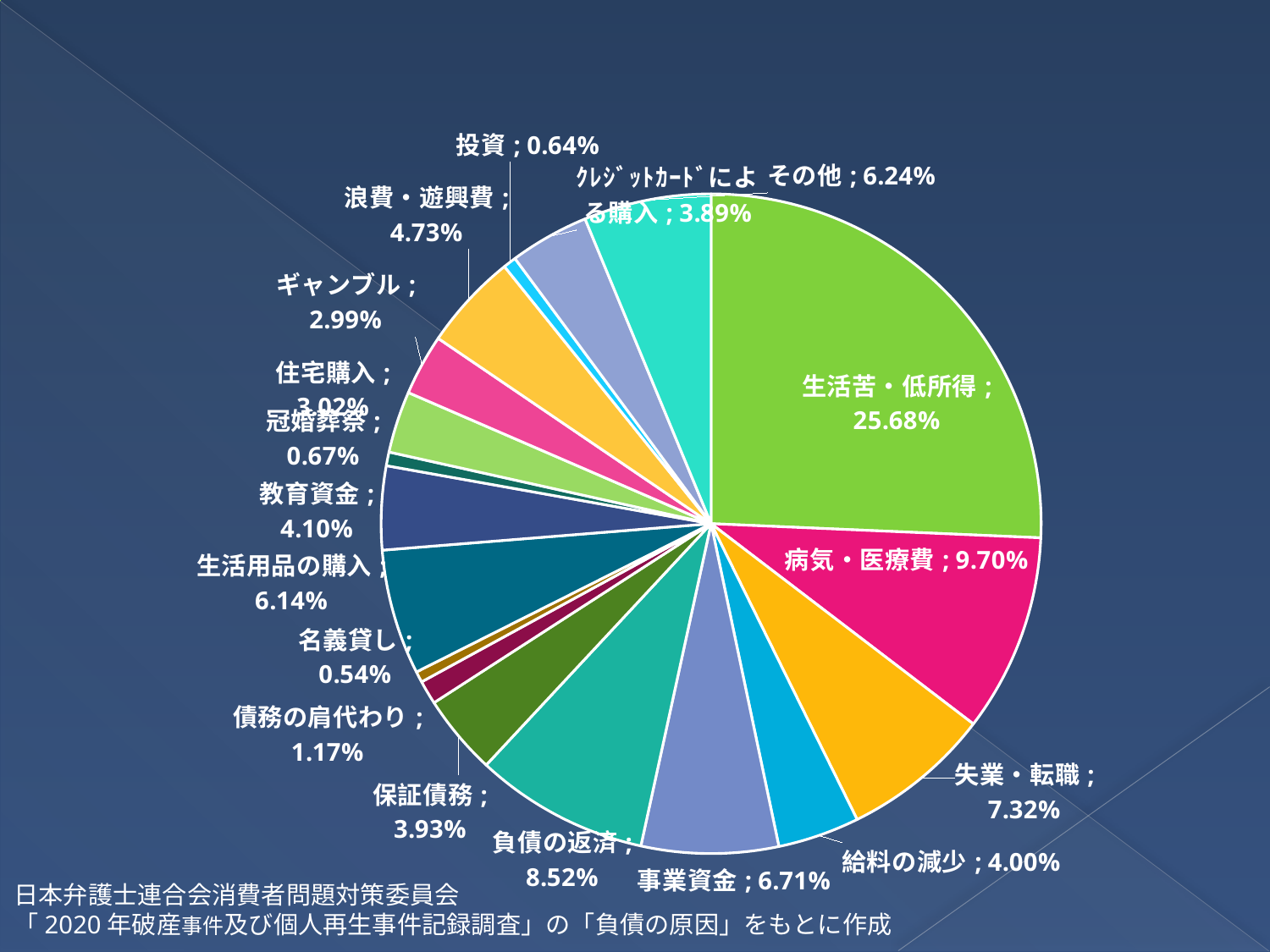
Which is larger, the share for 失業・転職 or the share for 事業資金? 失業・転職 What type of chart is shown on the slide? pie chart What is the combined share of 教育資金 and 給料の減少? 8.10% What percentage is shown for 負債の返済? 8.52% What percentage is shown for クレジットカードによる購入? 3.89% Which category has the largest share of the pie? 生活苦・低所得 How many slices does the pie chart have? 18 What is the difference between the shares of 生活苦・低所得 and 病気・医療費? 15.98% What percentage is shown for その他? 6.24% Which category has the smallest share of the pie? 名義貸し What percentage is shown for 生活苦・低所得? 25.68% What percentage is shown for 病気・医療費? 9.70%